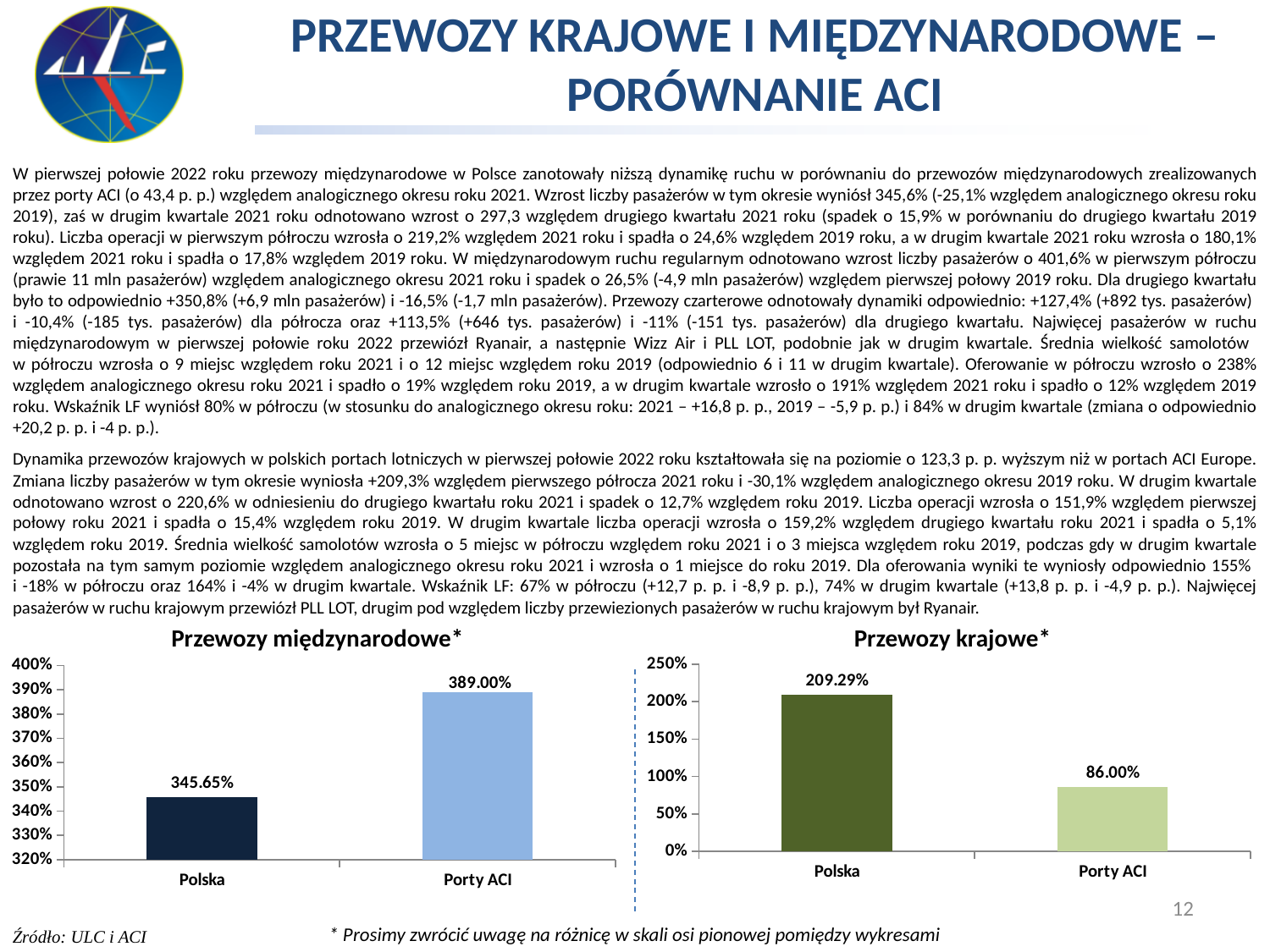
In the 'Przewozy międzynarodowe*' chart, is the value for Polska greater or less than 350%? less In the 'Przewozy krajowe*' chart, is the value for Polska greater or less than 200%? greater In the 'Przewozy krajowe*' chart, what is the value for Polska? 209.29% What type of chart is the 'Przewozy międzynarodowe*' chart? Bar chart How many categories are shown in the 'Przewozy krajowe*' chart? 2 In the 'Przewozy międzynarodowe*' chart, what is the value for Polska? 345.65% In the 'Przewozy międzynarodowe*' chart, what is the difference between the values for Porty ACI and Polska? 43.35 percentage points In the 'Przewozy międzynarodowe*' chart, what is the value for Porty ACI? 389.00% In the 'Przewozy krajowe*' chart, what is the difference between the values for Polska and Porty ACI? 123.29 percentage points In the 'Przewozy krajowe*' chart, which category has the lower value? Porty ACI In the 'Przewozy międzynarodowe*' chart, which category has the higher value? Porty ACI In the 'Przewozy krajowe*' chart, what is the value for Porty ACI? 86.00%